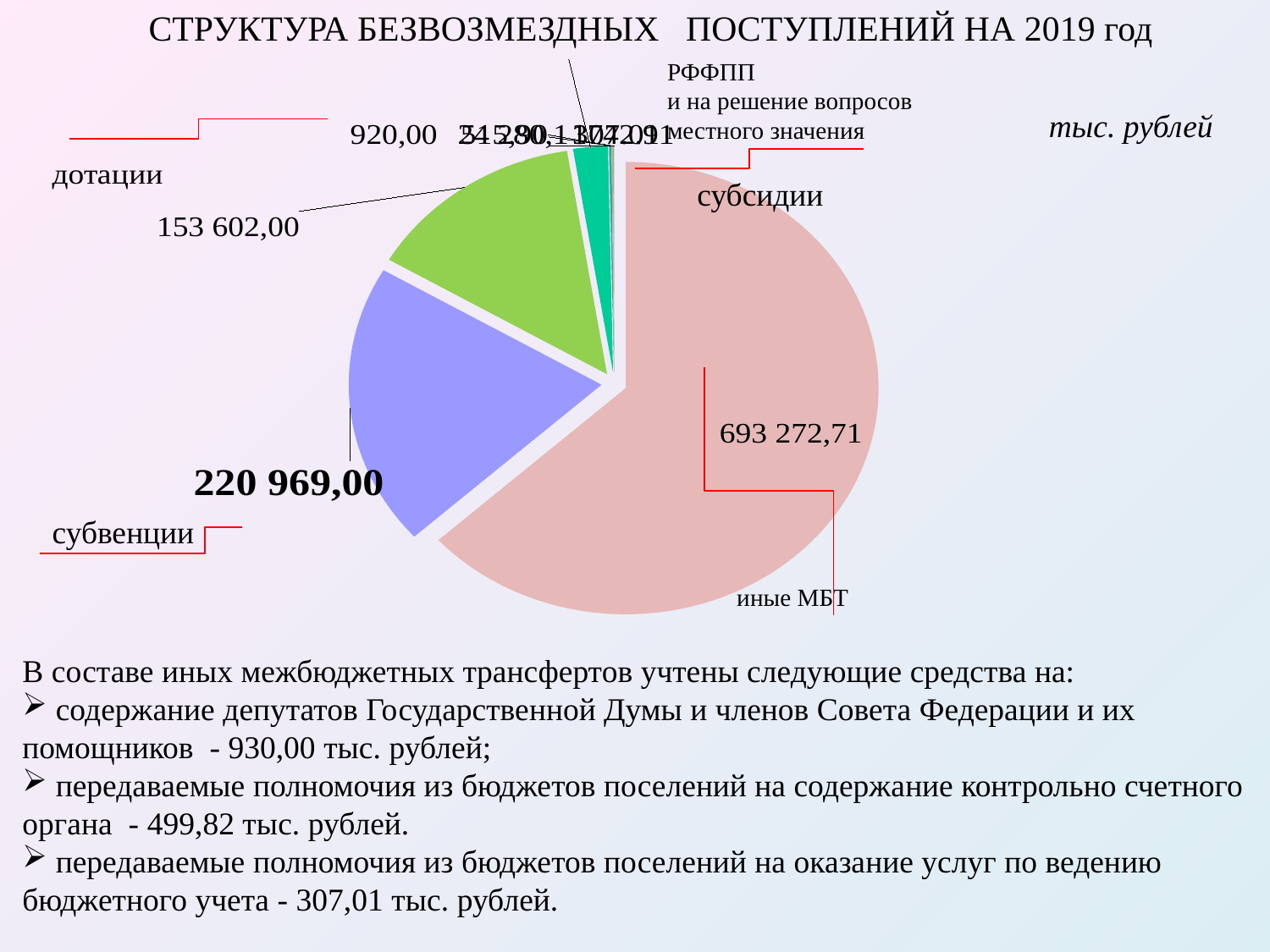
Which is larger, субвенции or дотации? субвенции What is the value for дотации? 153 602,00 What is the value for субвенции? 220 969,00 What is the value for субсидии? 693 272,71 What is the difference between the values for субсидии and субвенции? 472 303,71 Which category has the largest slice of the pie? субсидии Which is larger, субсидии or субвенции? субсидии In what units are the values on the chart given? тыс. рублей What is the difference between the values for субвенции and дотации? 67 367,00 What colour is the субсидии slice? pink What kind of chart is shown on the slide? pie chart